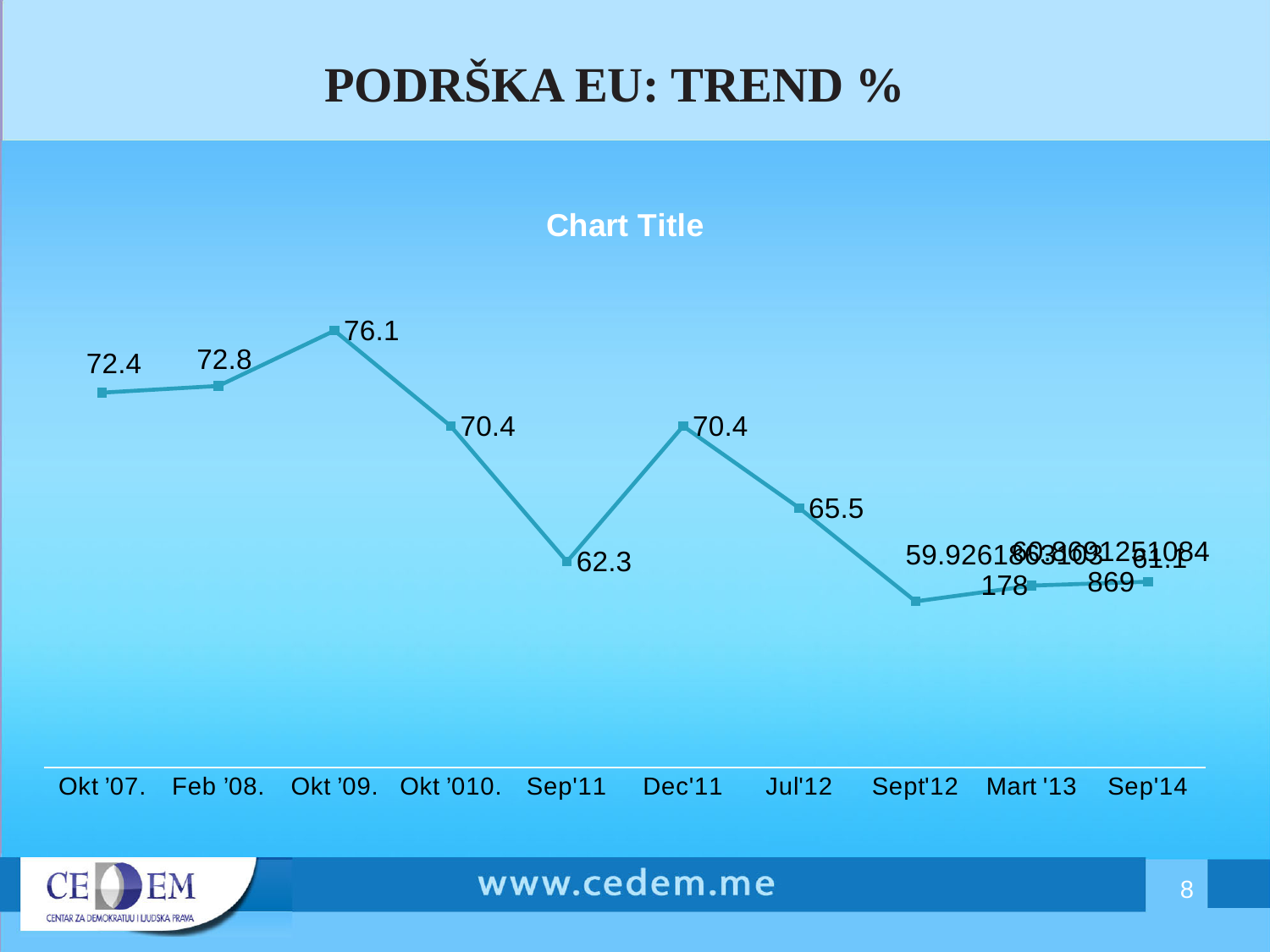
Which category has the lowest value? Sept'12 What is the value for Sep'11? 62.3 Which category has the highest value? Okt '09. What is the difference between the values for Okt '09. and Sep'11? 13.8 What is the value for Jul'12? 65.5 How many data points are plotted on the line? 10 What is the value for Okt '07.? 72.4 Do the values rise or fall from Dec'11 to Sept'12? fall What is the value for Okt '09.? 76.1 Which is larger, the value for Feb '08. or the value for Okt '07.? Feb '08. What kind of chart is shown on the slide? line chart What is the value for Dec'11? 70.4